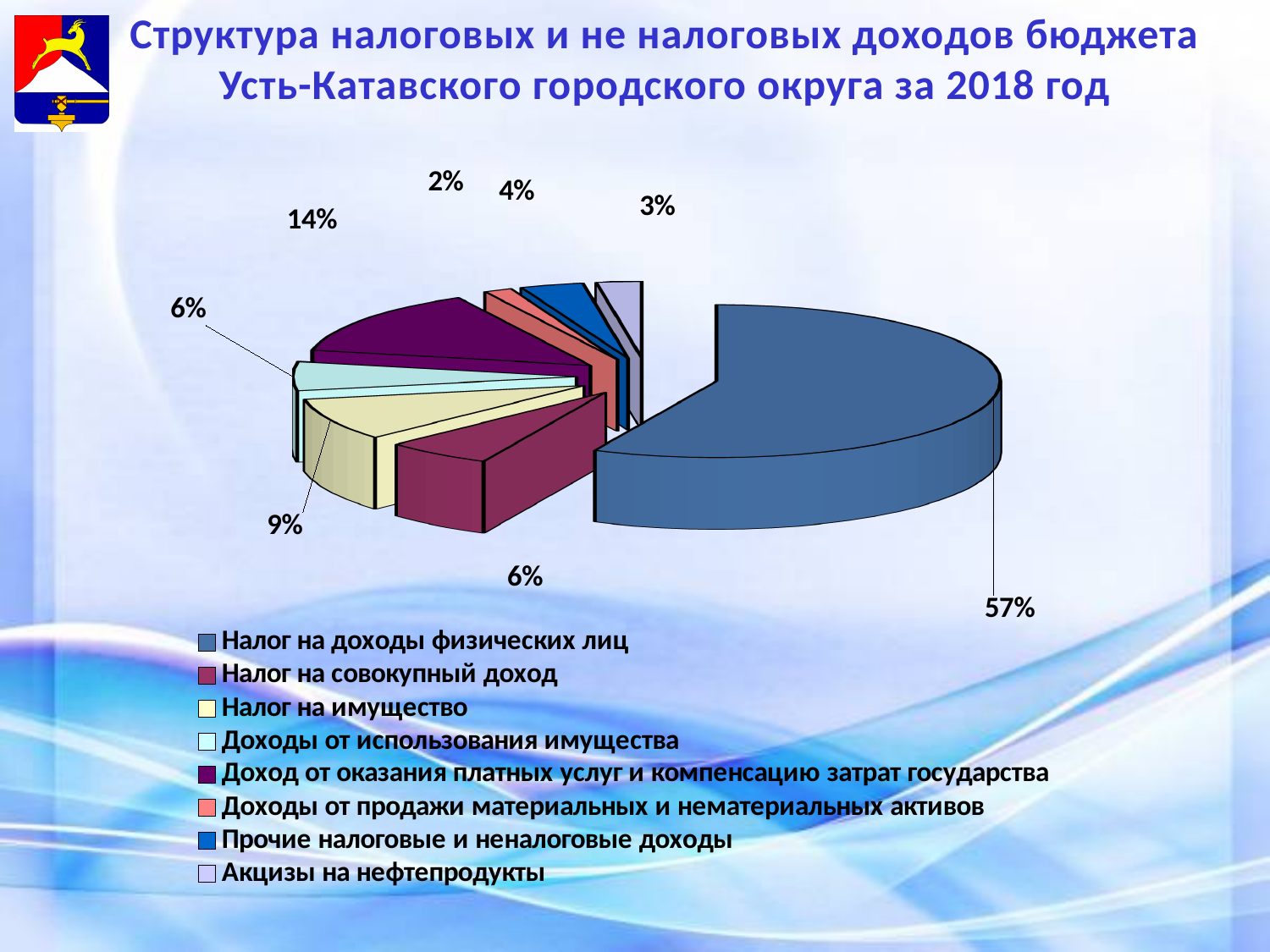
What share is shown for Налог на имущество? 9% Which year does the chart title say the budget revenue structure refers to? 2018 How many slices does the pie chart have? 8 How many entries does the legend list? 8 Which is larger: the share for Налог на имущество or the share for Прочие налоговые и неналоговые доходы? Налог на имущество Which category has the smallest slice of the pie? Доходы от продажи материальных и нематериальных активов Which category has the largest slice of the pie? Налог на доходы физических лиц What share is shown for Акцизы на нефтепродукты? 3% What kind of chart is shown on the slide? pie chart What share is shown for Доход от оказания платных услуг и компенсацию затрат государства? 14% What is the difference in percentage points between Налог на доходы физических лиц and Доход от оказания платных услуг и компенсацию затрат государства? 43 What share of the budget revenue comes from Налог на доходы физических лиц? 57%